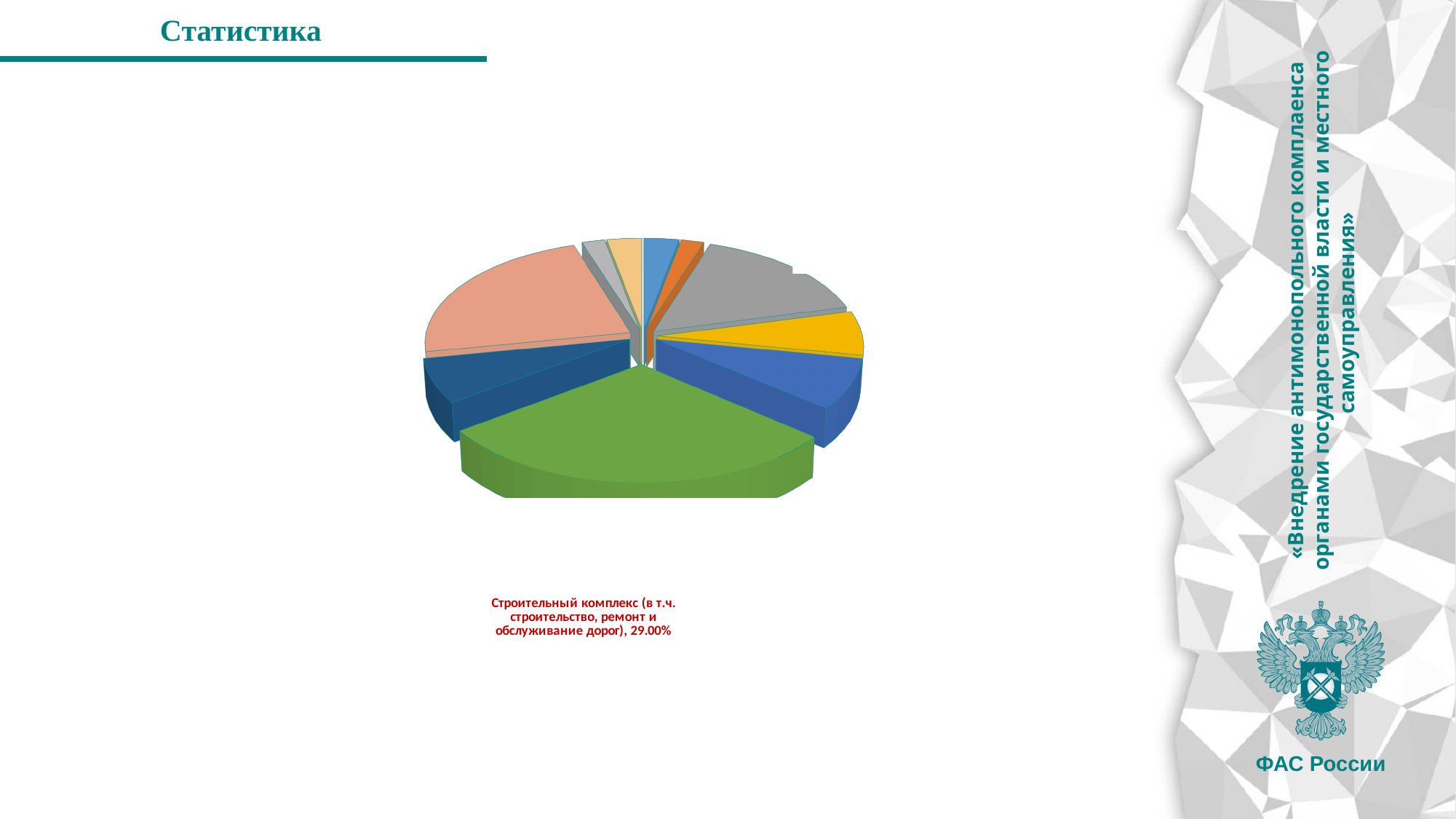
Which category has the largest slice of the pie? Строительный комплекс (в т.ч. строительство, ремонт и обслуживание дорог) What value is printed on the data label for Строительный комплекс? 29.00% What share of the pie is labelled for Строительный комплекс (в т.ч. строительство, ремонт и обслуживание дорог)? 29.00% What colour is the slice labelled Строительный комплекс, 29.00%? green Is the share for Строительный комплекс greater or less than 50%? less Which is larger, the yellow slice or the green slice? the green slice What kind of chart is shown on the slide? pie chart What is the title of the slide containing the pie chart? Статистика Which is larger, the green slice or the salmon-coloured slice? the green slice Is the share for Строительный комплекс greater or less than 25%? greater